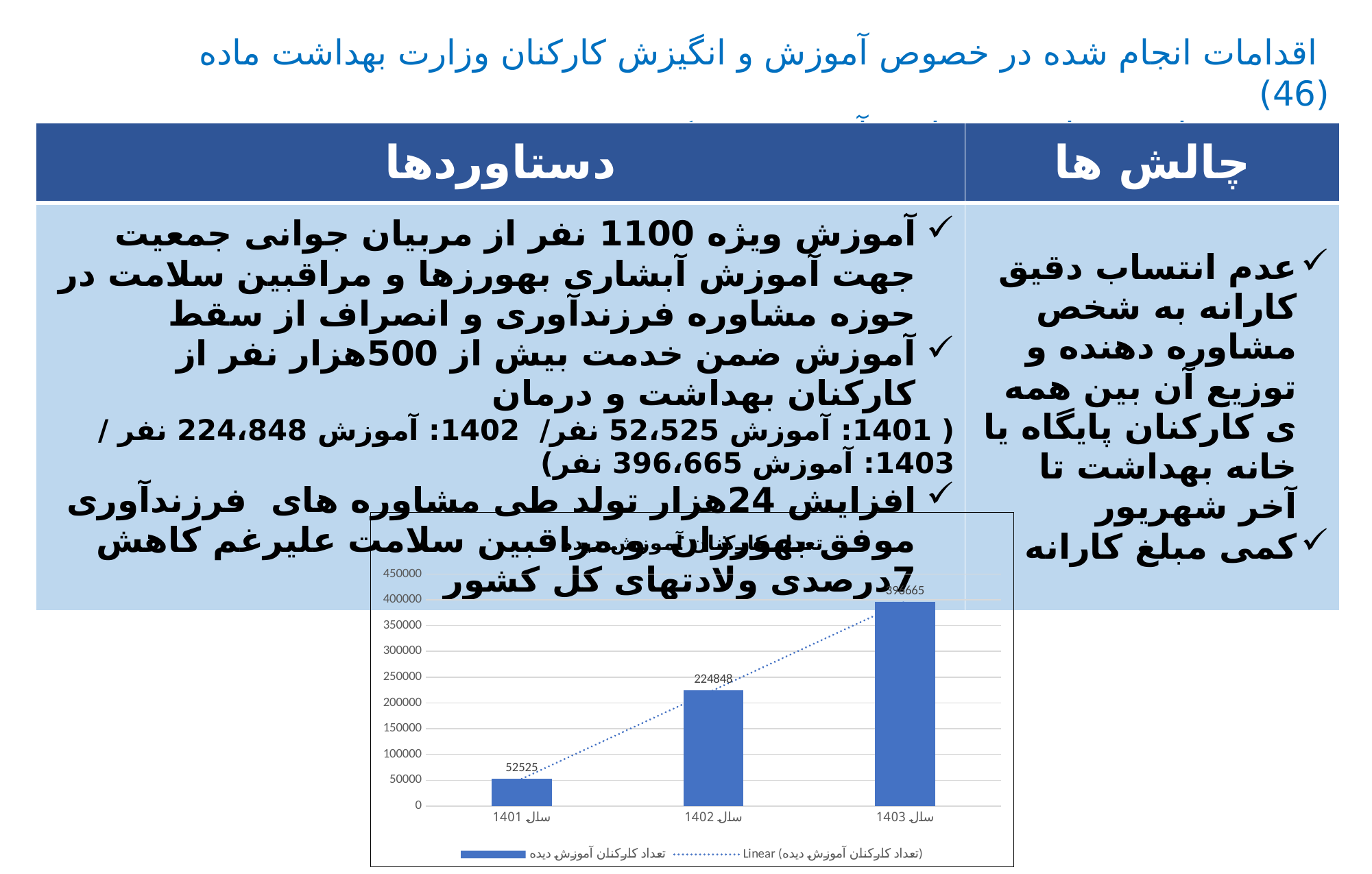
What style of line is used for the Linear trendline in the chart? dotted line What is the value shown for سال 1401 in the chart? 52525 What is the value shown for سال 1402 in the chart? 224848 How many bars (years) are plotted in the chart? 3 Which year has the highest bar in the chart? سال 1403 How many entries does the chart legend list? 2 What is the difference between the values for سال 1402 and سال 1401? 172323 Is the value for سال 1403 greater or less than 350000? greater Which year has the lowest bar in the chart? سال 1401 What kind of chart is shown on the slide? bar chart Do the bar values rise or fall from سال 1401 to سال 1403? rise Which is larger, the value for سال 1402 or the value for سال 1401? سال 1402